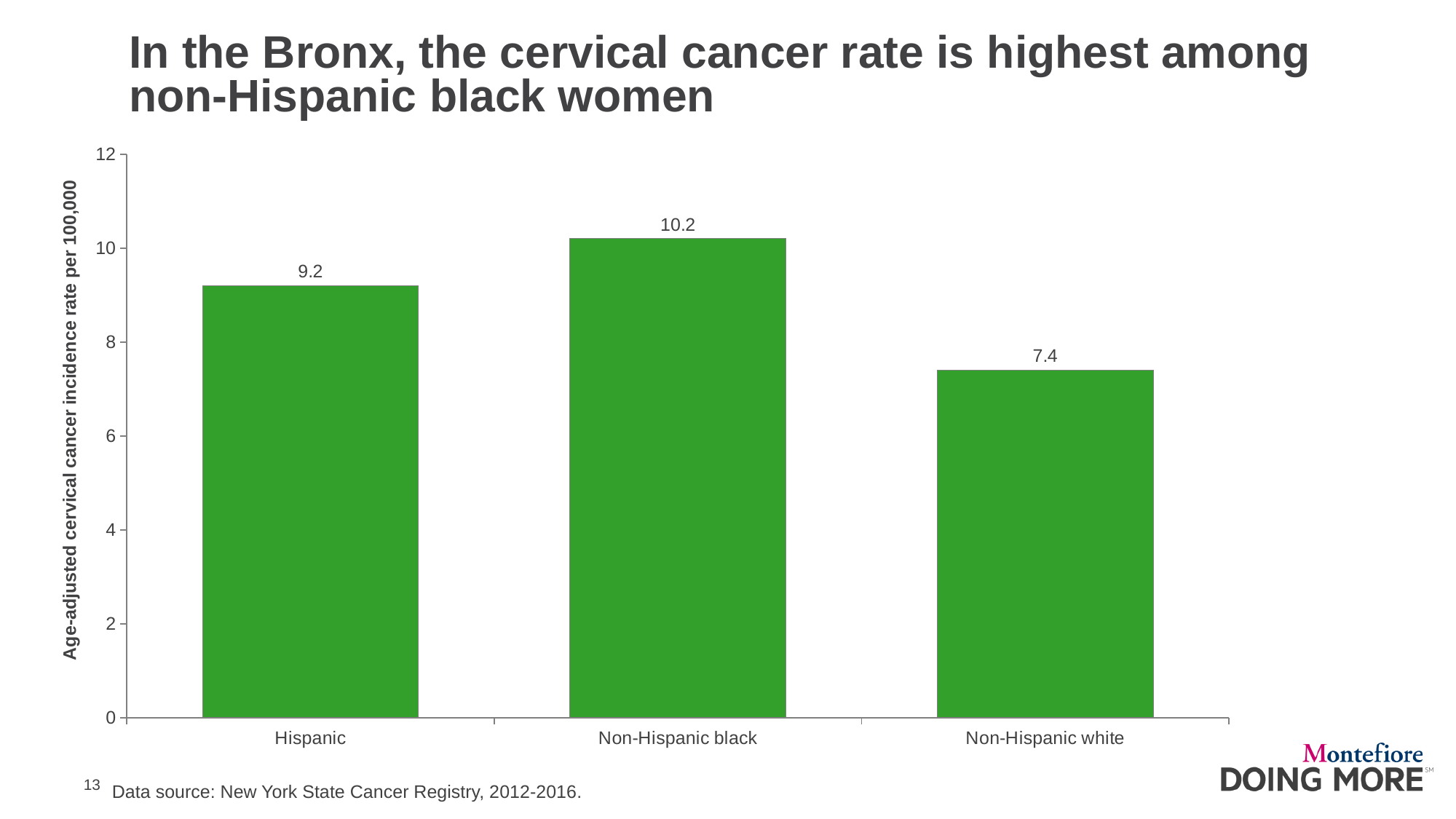
What kind of chart is shown on the slide? Bar chart Is the cervical cancer incidence rate for non-Hispanic black women greater or less than 10? greater What is the age-adjusted cervical cancer incidence rate per 100,000 for Hispanic women? 9.2 Which is larger, the cervical cancer incidence rate for Hispanic women or for non-Hispanic white women? Hispanic What is the age-adjusted cervical cancer incidence rate per 100,000 for non-Hispanic white women? 7.4 What is the age-adjusted cervical cancer incidence rate per 100,000 for non-Hispanic black women? 10.2 Which group has the lowest cervical cancer incidence rate? Non-Hispanic white What is the difference between the cervical cancer incidence rates for non-Hispanic black and non-Hispanic white women? 2.8 What is the label of the vertical axis? Age-adjusted cervical cancer incidence rate per 100,000 Which group has the highest cervical cancer incidence rate? Non-Hispanic black What is the difference between the cervical cancer incidence rates for non-Hispanic black and Hispanic women? 1.0 How many groups are shown in the chart? 3